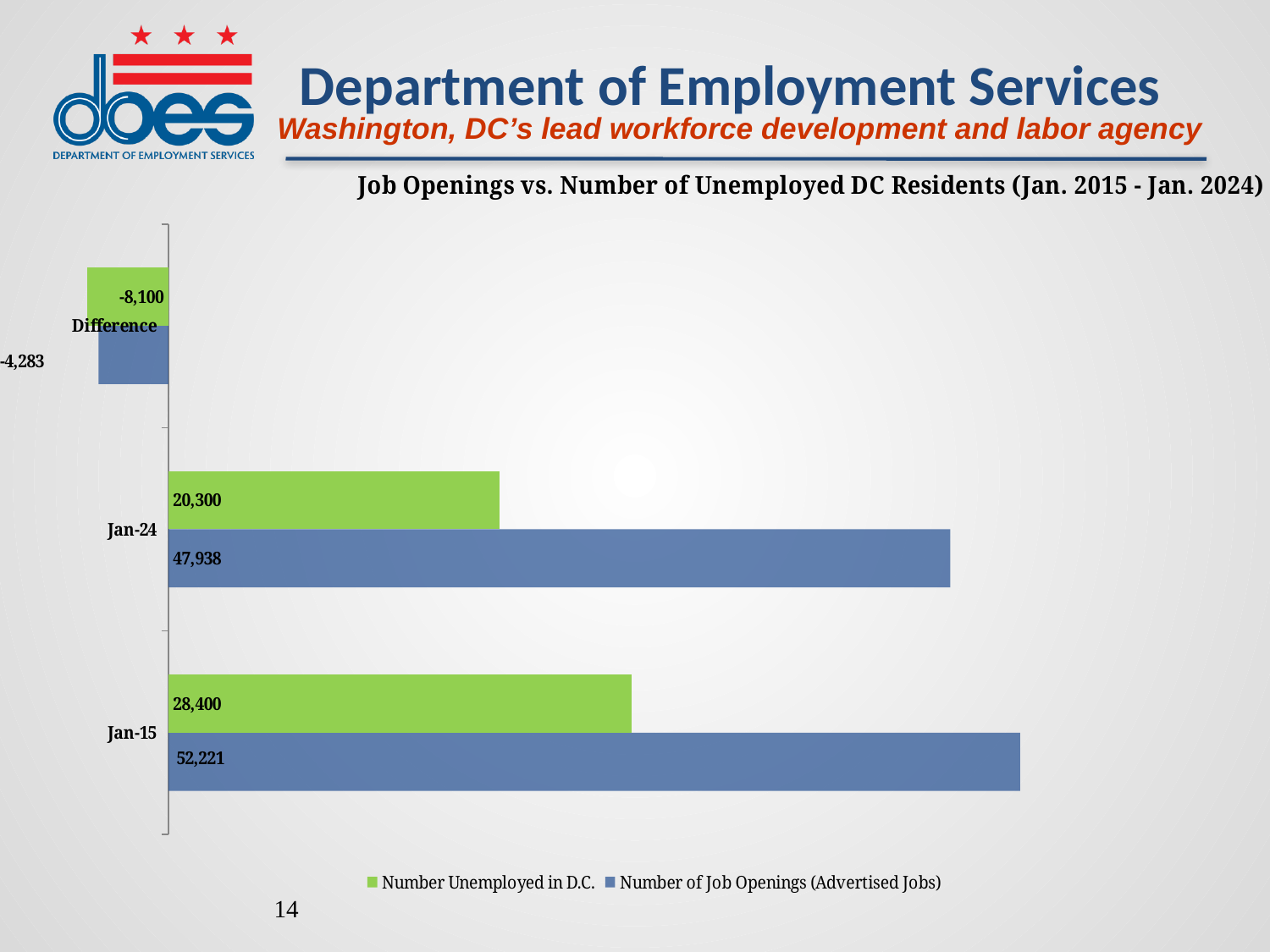
What is the Number of Job Openings (Advertised Jobs) for Jan-24? 47,938 What is the Number of Job Openings (Advertised Jobs) for Jan-15? 52,221 What is the Number Unemployed in D.C. for Jan-24? 20,300 What is the title of the chart? Job Openings vs. Number of Unemployed DC Residents (Jan. 2015 - Jan. 2024) How many series does the legend list? 2 Which category has the highest Number of Job Openings (Advertised Jobs)? Jan-15 What kind of chart is shown on the slide? Bar chart Which is larger for Jan-24: Number Unemployed in D.C. or Number of Job Openings (Advertised Jobs)? Number of Job Openings (Advertised Jobs) What is the difference between the Number of Job Openings (Advertised Jobs) and the Number Unemployed in D.C. for Jan-15? 23,821 What value is shown for the Difference category for Number of Job Openings (Advertised Jobs)? -4,283 What is the Number Unemployed in D.C. for Jan-15? 28,400 What value is shown for the Difference category for Number Unemployed in D.C.? -8,100